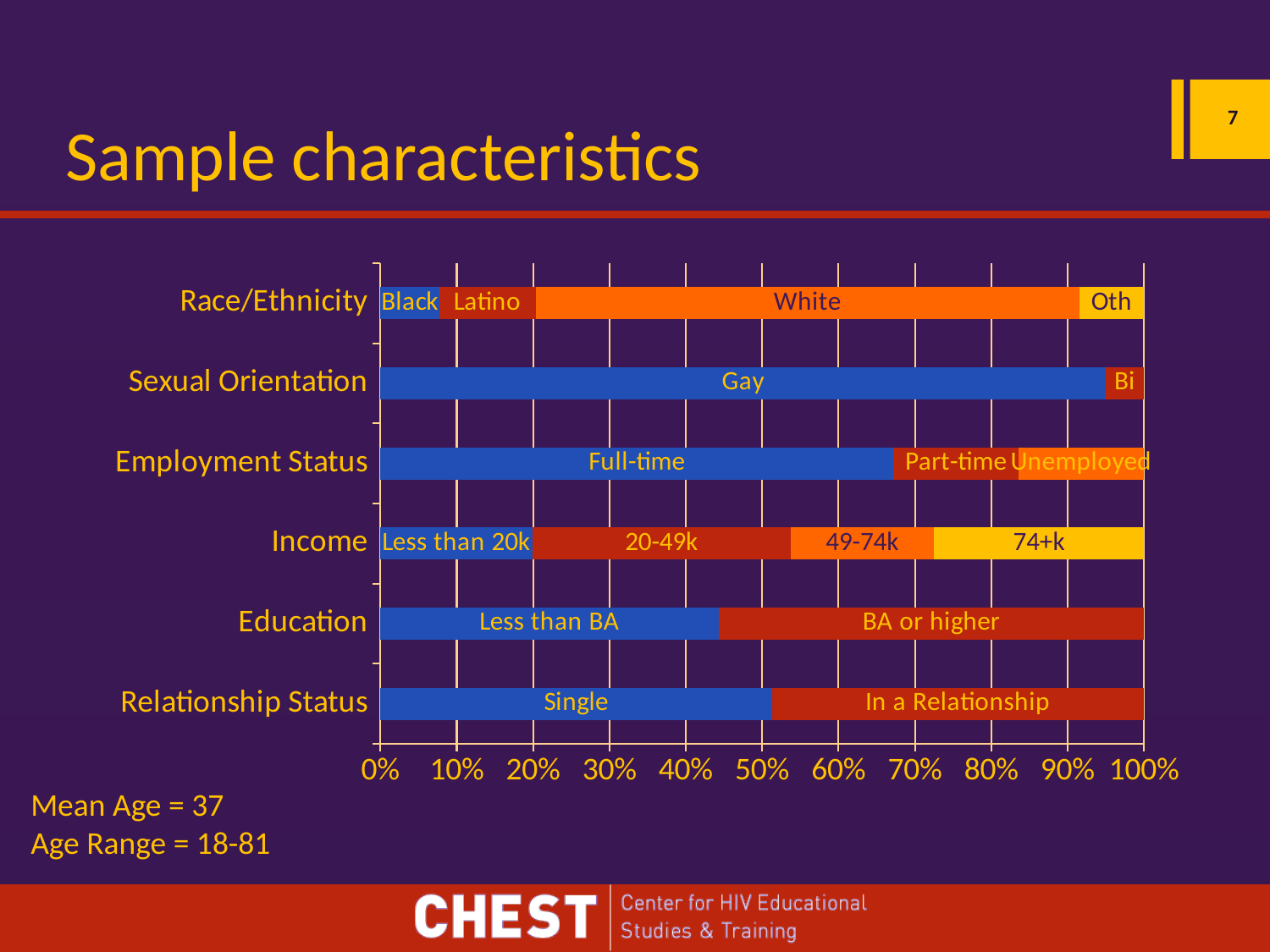
What kind of chart is shown on the slide? Stacked bar chart Is the share of the Full-time segment in the Employment Status bar greater or less than 60%? greater Is the share of the Black segment in the Race/Ethnicity bar greater or less than 10%? less Is the share of the White segment in the Race/Ethnicity bar greater or less than 50%? greater What is the title of the slide containing the chart? Sample characteristics In the Employment Status bar, which segment is larger: Full-time or Part-time? Full-time How many characteristic categories are plotted on the chart? 6 In the Education bar, which segment is larger: Less than BA or BA or higher? BA or higher Which category is shown at the top of the chart? Race/Ethnicity